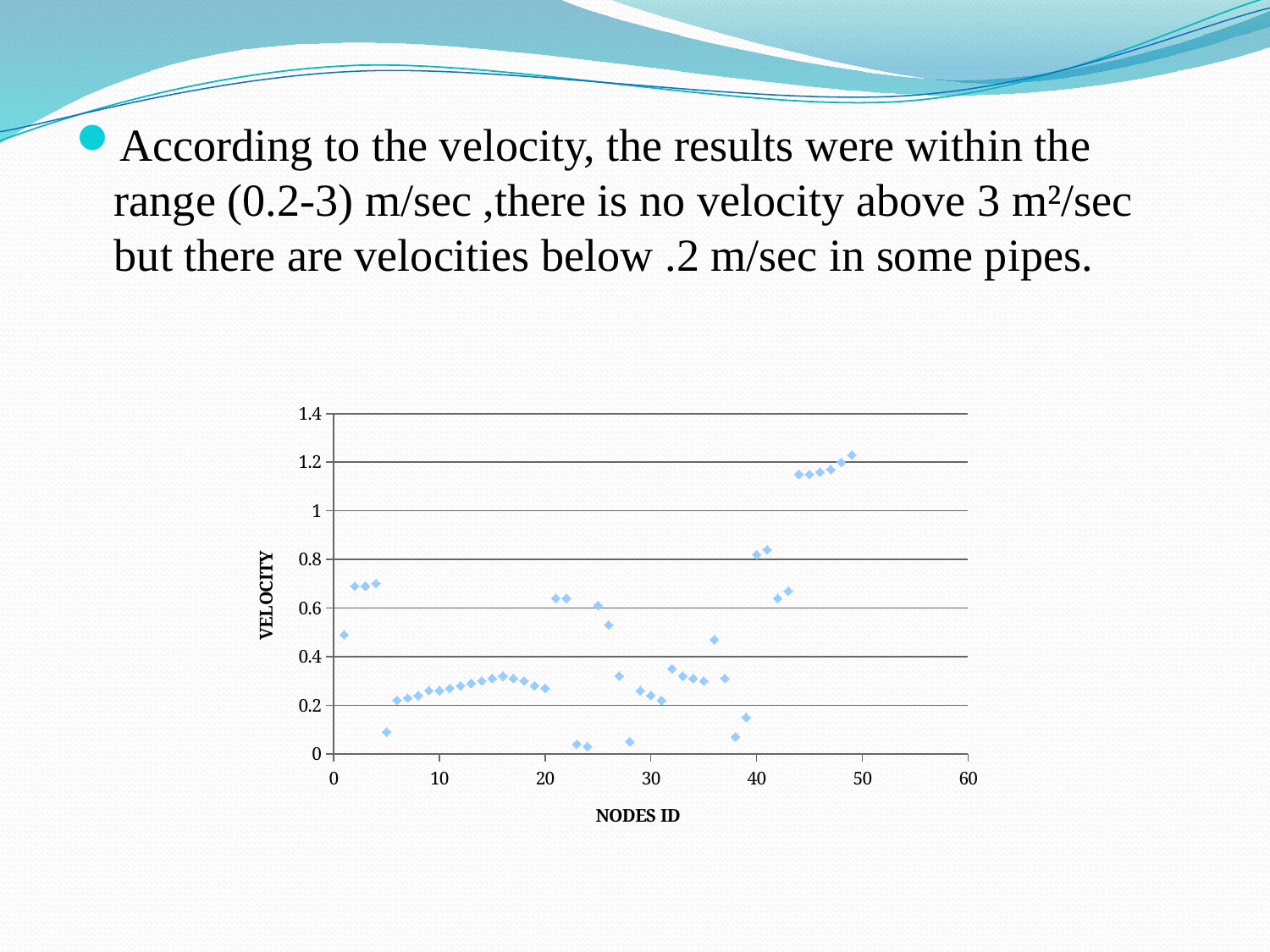
Is the velocity plotted for node ID 1 greater or less than 0.4? greater Is the velocity plotted for node ID 5 greater or less than 0.2? less What is the label of the x axis of the chart? NODES ID Is the velocity plotted for node ID 23 greater or less than 0.2? less What kind of chart is shown on the slide? scatter chart Which has the larger plotted velocity, node ID 45 or node ID 5? node ID 45 What is the label of the y axis of the chart? VELOCITY Which has the larger plotted velocity, node ID 1 or node ID 23? node ID 1